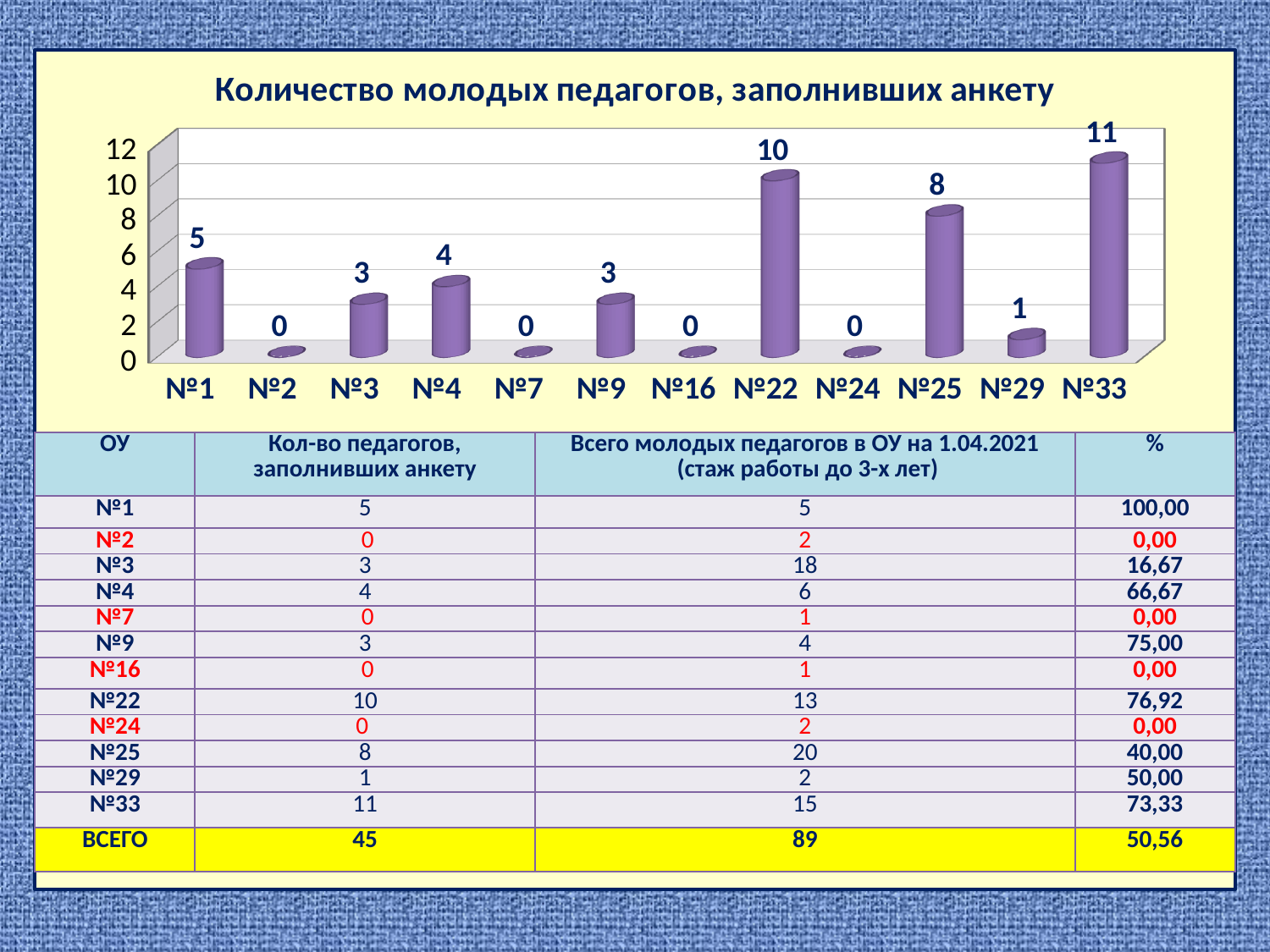
How many categories in the chart have a value of 0? 4 Is the value for №22 greater or less than 8? greater How many categories are shown on the x axis of the chart? 12 What is the value for №22 in the chart? 10 What is the value for №29 in the chart? 1 Which is larger in the chart, the value for №4 or the value for №9? №4 What is the difference between the values for №33 and №1? 6 What is the highest tick value shown on the vertical axis of the chart? 12 What is the value for №25 in the chart? 8 Which category has the highest value in the chart? №33 What kind of chart is shown on the slide? bar chart What is the title of the chart? Количество молодых педагогов, заполнивших анкету